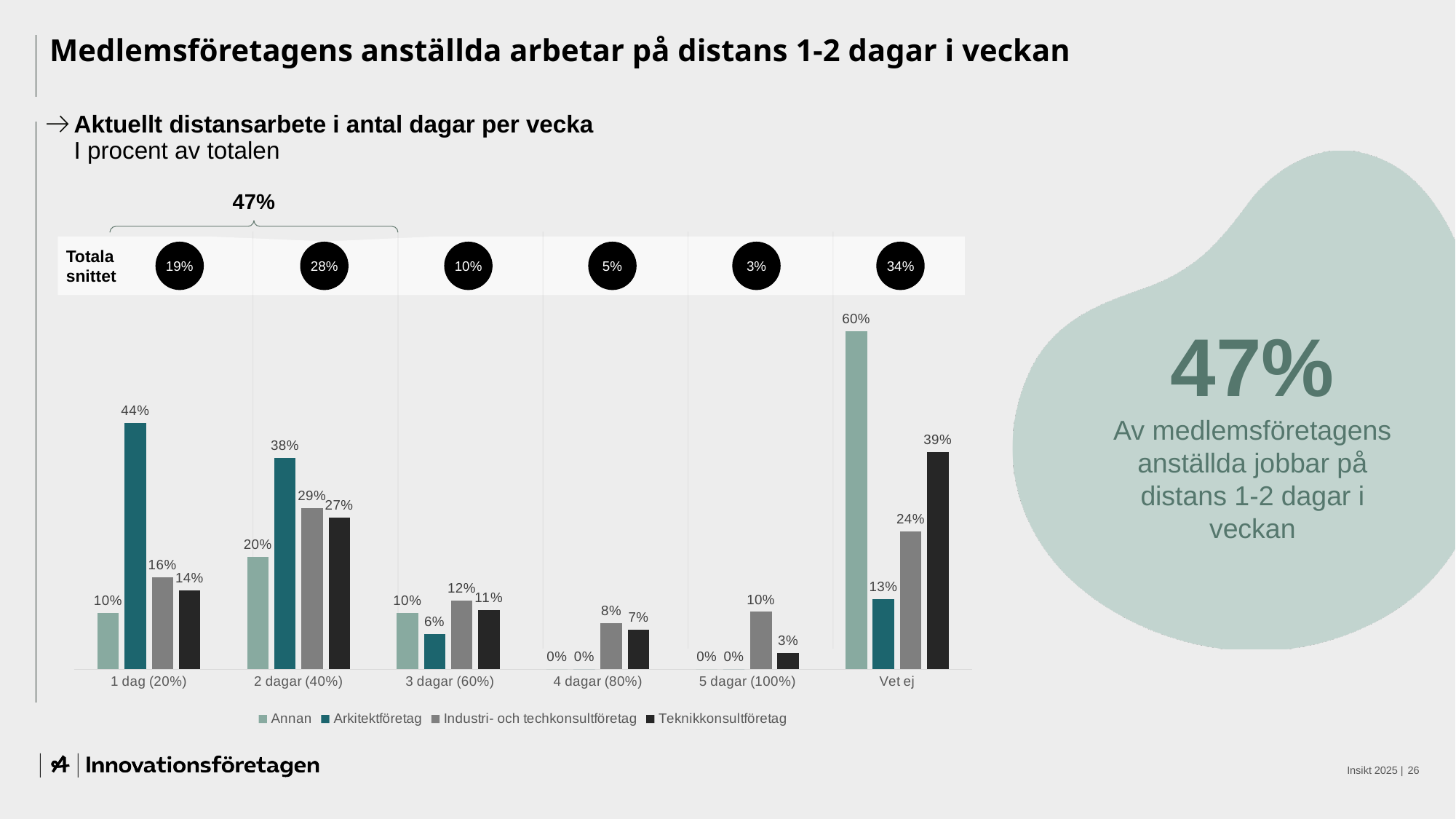
What kind of chart is shown on the slide? Bar chart Which series has the lowest value in the 'Vet ej' category? Arkitektföretag What is the value for Arkitektföretag in the '1 dag (20%)' category? 44% What is the value for Teknikkonsultföretag in the '2 dagar (40%)' category? 27% What is the combined 'Totala snittet' share for 1 and 2 days shown above the bracket? 47% How many series does the legend list? 4 What is the value for Annan in the 'Vet ej' category? 60% Which series has the highest value in the '2 dagar (40%)' category? Arkitektföretag What is the difference between Arkitektföretag and Annan in the '1 dag (20%)' category? 34% Which is larger in the '3 dagar (60%)' category: Industri- och techkonsultföretag or Teknikkonsultföretag? Industri- och techkonsultföretag How many categories are shown on the x axis? 6 What is the 'Totala snittet' value shown for '2 dagar (40%)'? 28%